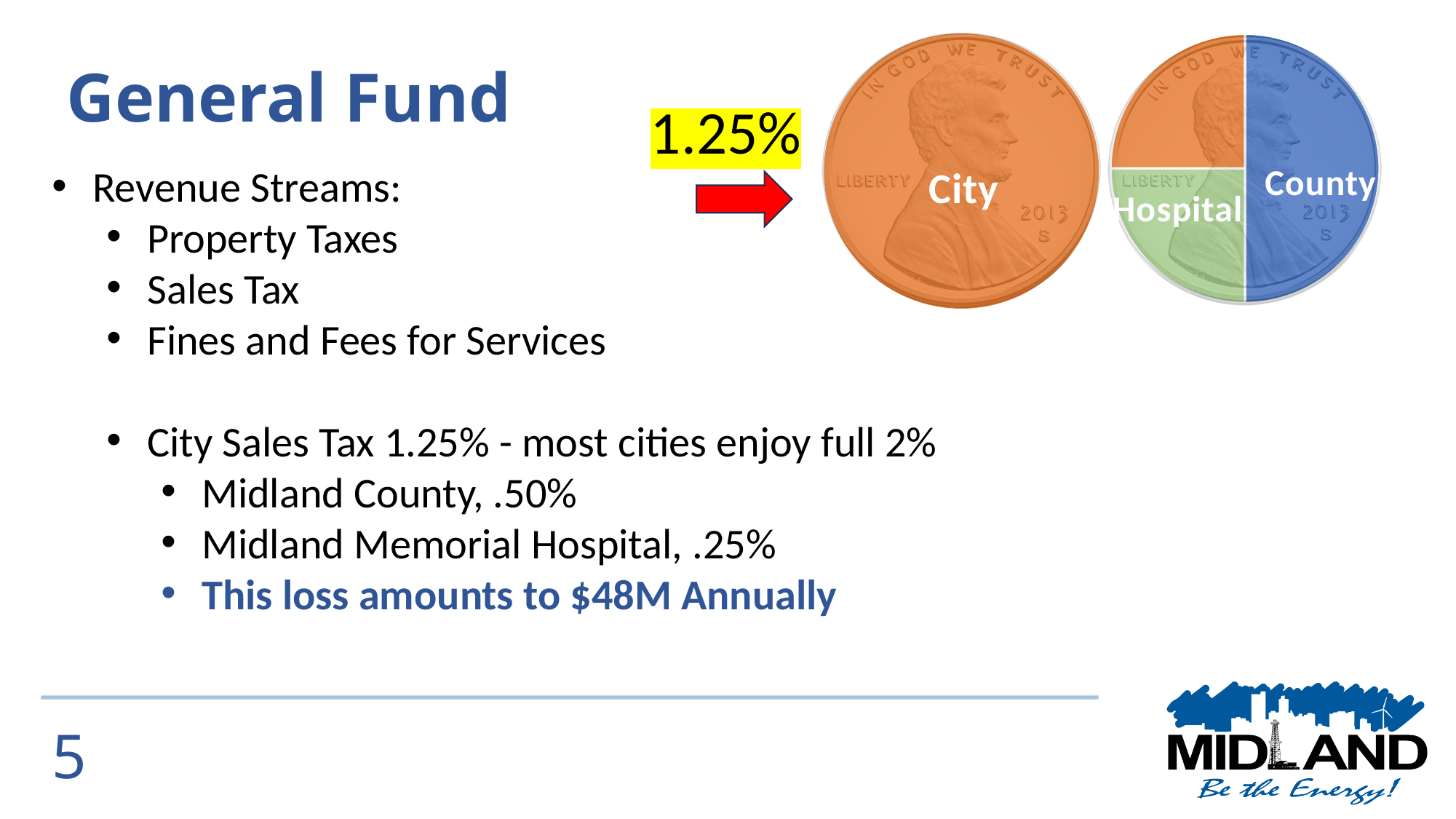
What colour is the County segment of the divided penny? blue What value is highlighted in yellow next to the full penny? 1.25% What kind of chart is the divided penny on the right of the slide? pie chart Which segment of the divided penny is the largest? County What is the difference between the County rate (.50%) and the Hospital rate (.25%)? .25% What sales tax rate is shown for Midland Memorial Hospital? .25% Which is larger, the County rate or the Hospital rate? County How many segments does the divided penny on the right show? 3 What sales tax rate is shown for the City (the full penny)? 1.25% What share of the divided penny does the County segment take up? half What sales tax rate is shown for Midland County? .50%